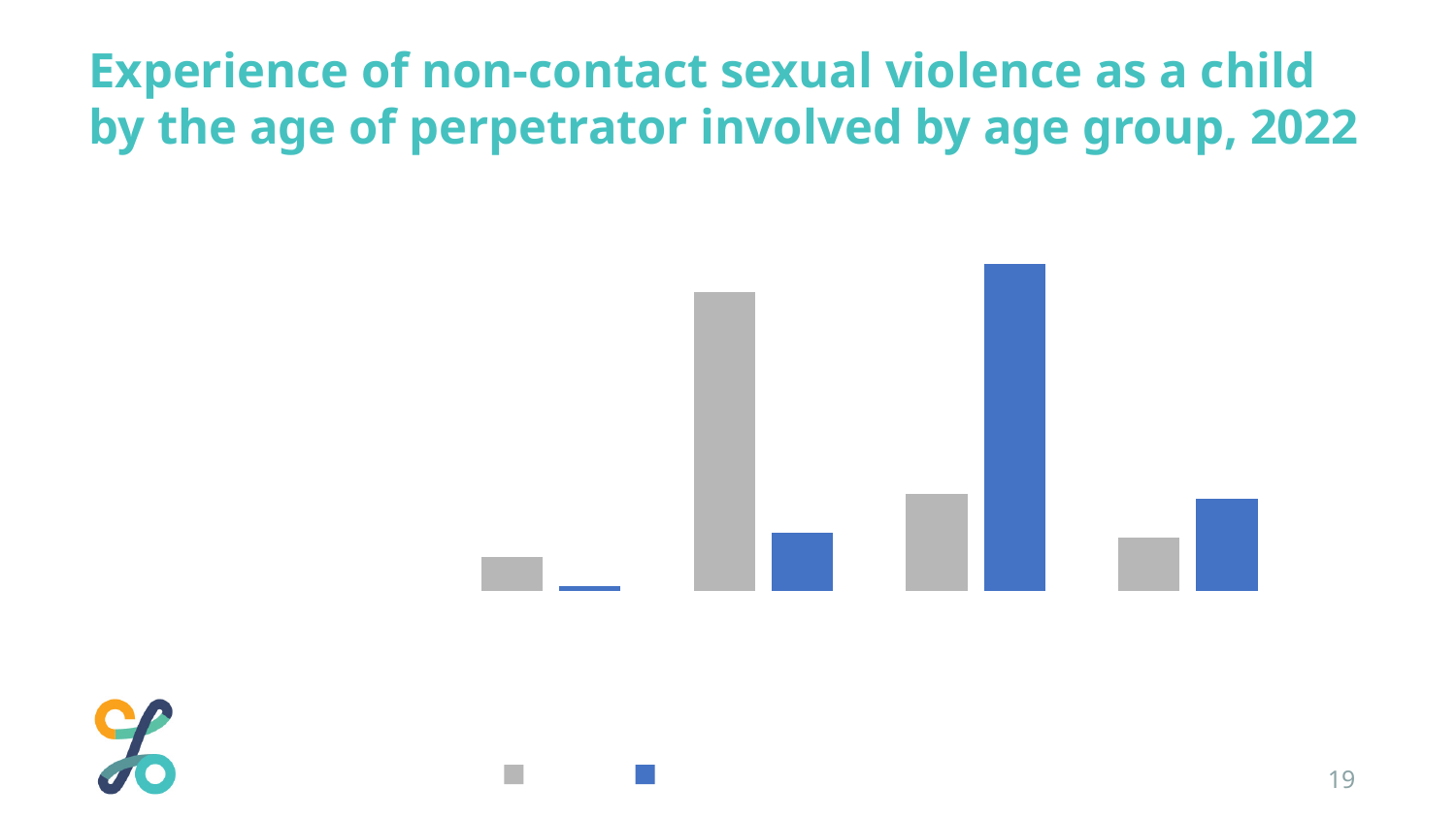
What is the title of the chart on the slide? Experience of non-contact sexual violence as a child by the age of perpetrator involved by age group, 2022 How many series does the legend show? 2 How many groups of bars are plotted in the chart? 4 Which colour series contains the tallest bar in the chart? blue In the third group of bars from the left, is the grey bar or the blue bar taller? blue What two colours are used for the bars in the chart? grey and blue What type of chart is shown on the slide? bar chart In the leftmost group of bars, is the grey bar or the blue bar taller? grey